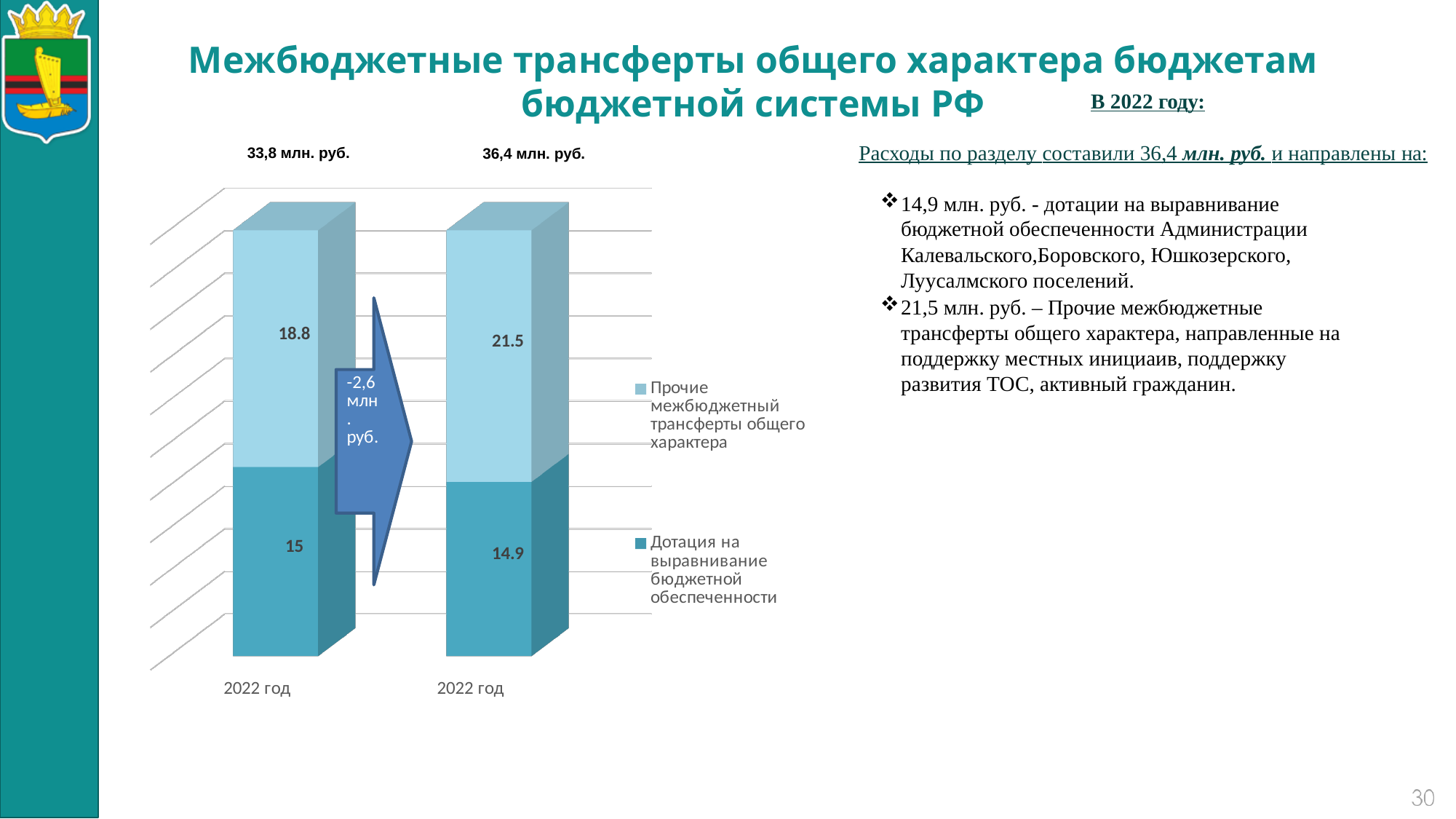
Which bar has the larger 'Дотация на выравнивание бюджетной обеспеченности' segment, the left or the right? left What total is printed above the left bar? 33,8 млн. руб. What is the value of the 'Дотация на выравнивание бюджетной обеспеченности' segment in the left bar? 15 How many bars are plotted in the chart? 2 What total is printed above the right bar? 36,4 млн. руб. What is the value of the 'Прочие межбюджетный трансферты общего характера' segment in the right bar? 21.5 What is the value of the 'Дотация на выравнивание бюджетной обеспеченности' segment in the right bar? 14.9 What is the value of the 'Прочие межбюджетный трансферты общего характера' segment in the left bar? 18.8 What kind of chart is shown on the slide? stacked bar chart What value is written inside the arrow between the two bars? -2,6 млн. руб. What is the difference between the 'Прочие межбюджетный трансферты общего характера' values of the right bar and the left bar? 2.7 How many series does the chart legend list? 2